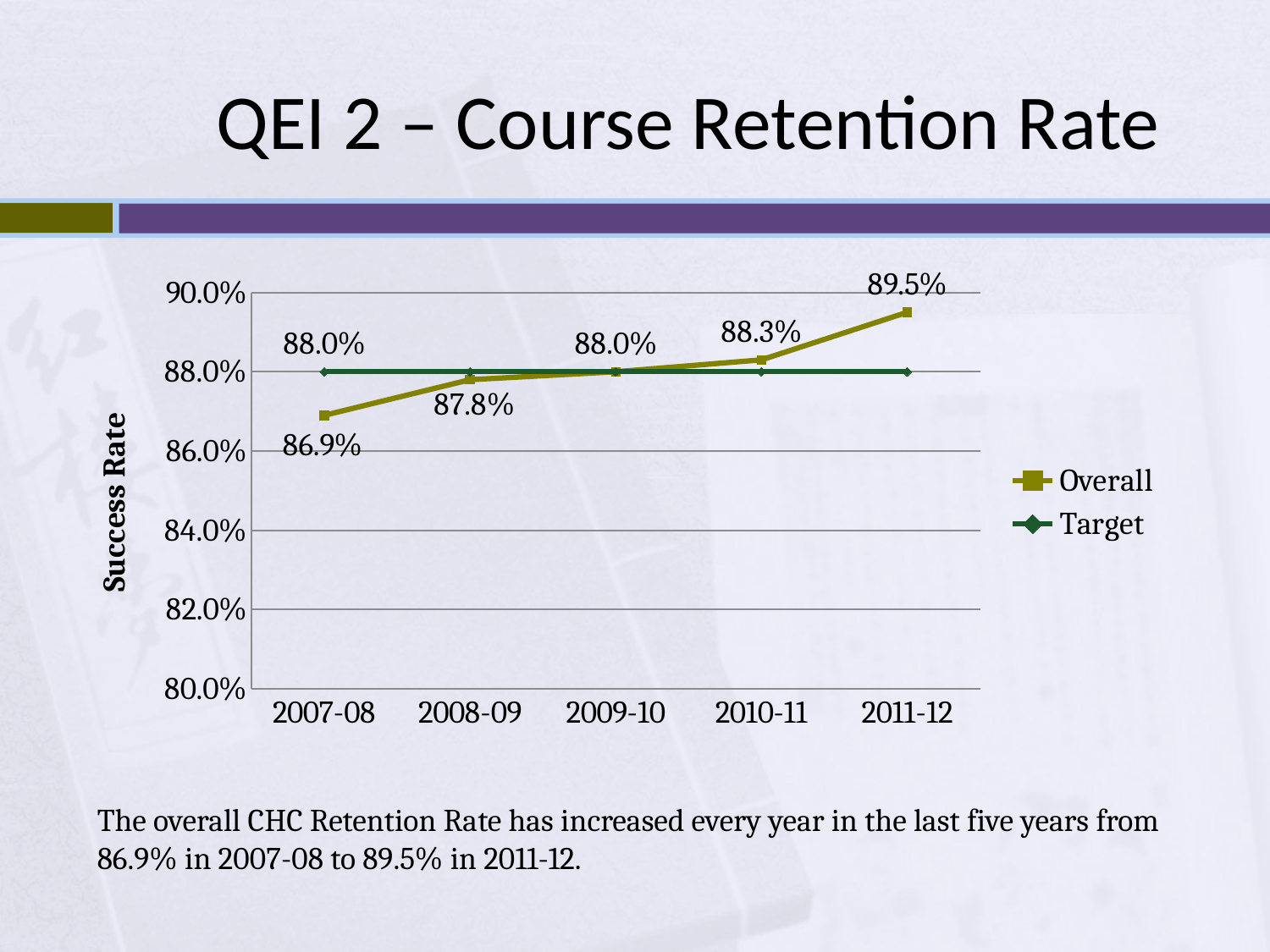
How many years are shown on the x axis? 5 Which year has the lowest Overall course retention rate? 2007-08 Is the Overall rate for 2008-09 greater or less than 88.0%? less How many series does the legend list? 2 What is the Overall course retention rate for 2007-08? 86.9% Which is larger, the Overall rate in 2010-11 or the Target rate? Overall rate in 2010-11 What kind of chart is shown on the slide? Line chart What is the Overall course retention rate for 2010-11? 88.3% Which year has the highest Overall course retention rate? 2011-12 By how many percentage points did the Overall rate increase from 2007-08 to 2011-12? 2.6 percentage points What is the Overall course retention rate for 2008-09? 87.8% What is the Overall course retention rate for 2011-12? 89.5%